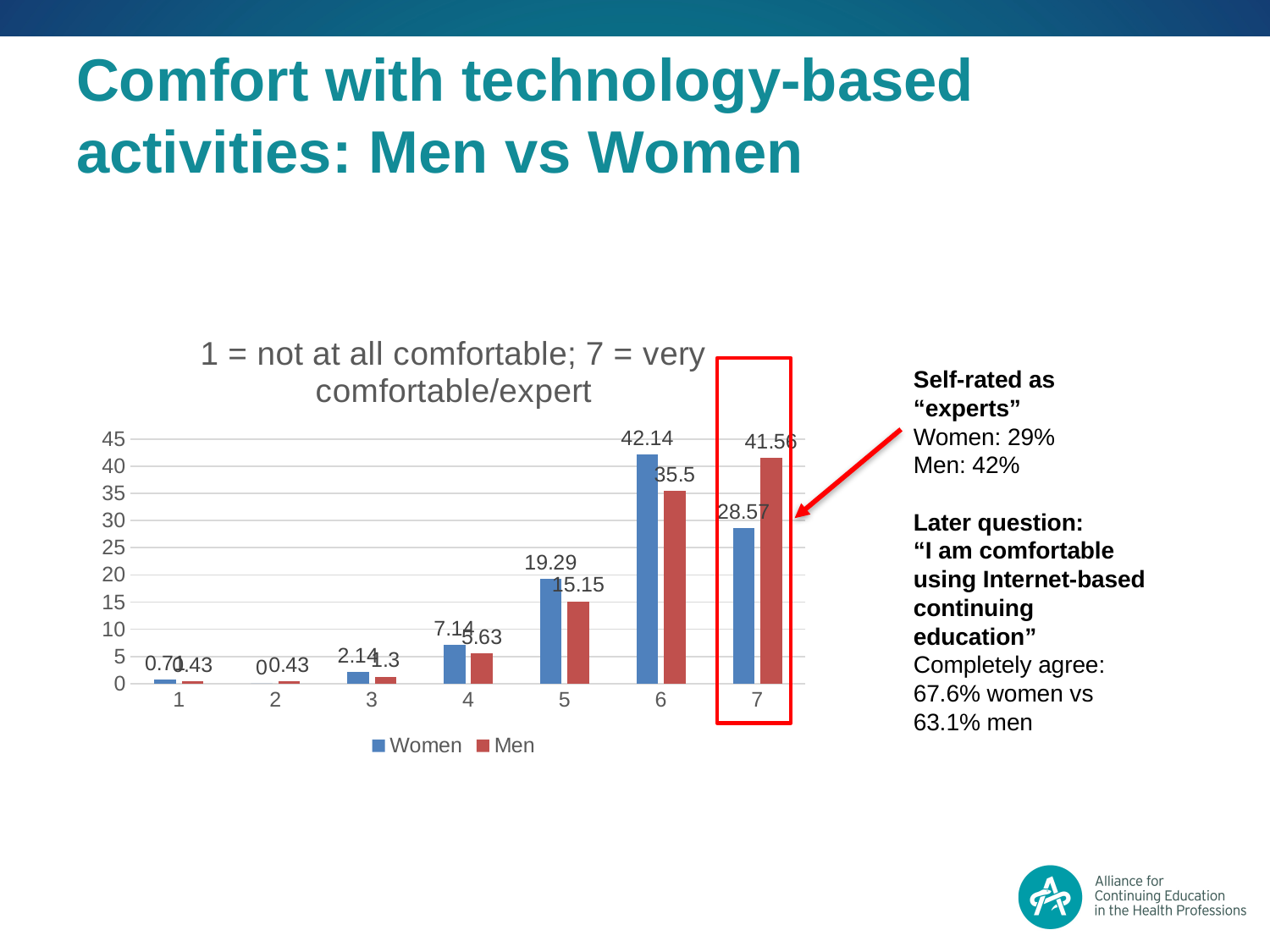
At which rating is the Men series highest? 7 Is the value for Men at rating 6 greater or less than 30? greater What is the value for Men at rating 7? 41.56 How many rating categories are shown on the x axis? 7 What is the value for Men at rating 5? 15.15 What is the difference between the Men and Women values at rating 7? 12.99 At which rating is the Women series highest? 6 What is the value for Women at rating 7? 28.57 At rating 6, which series has the larger value, Women or Men? Women What is the value for Women at rating 6? 42.14 How many series does the legend list? 2 What kind of chart is shown on the slide? bar chart